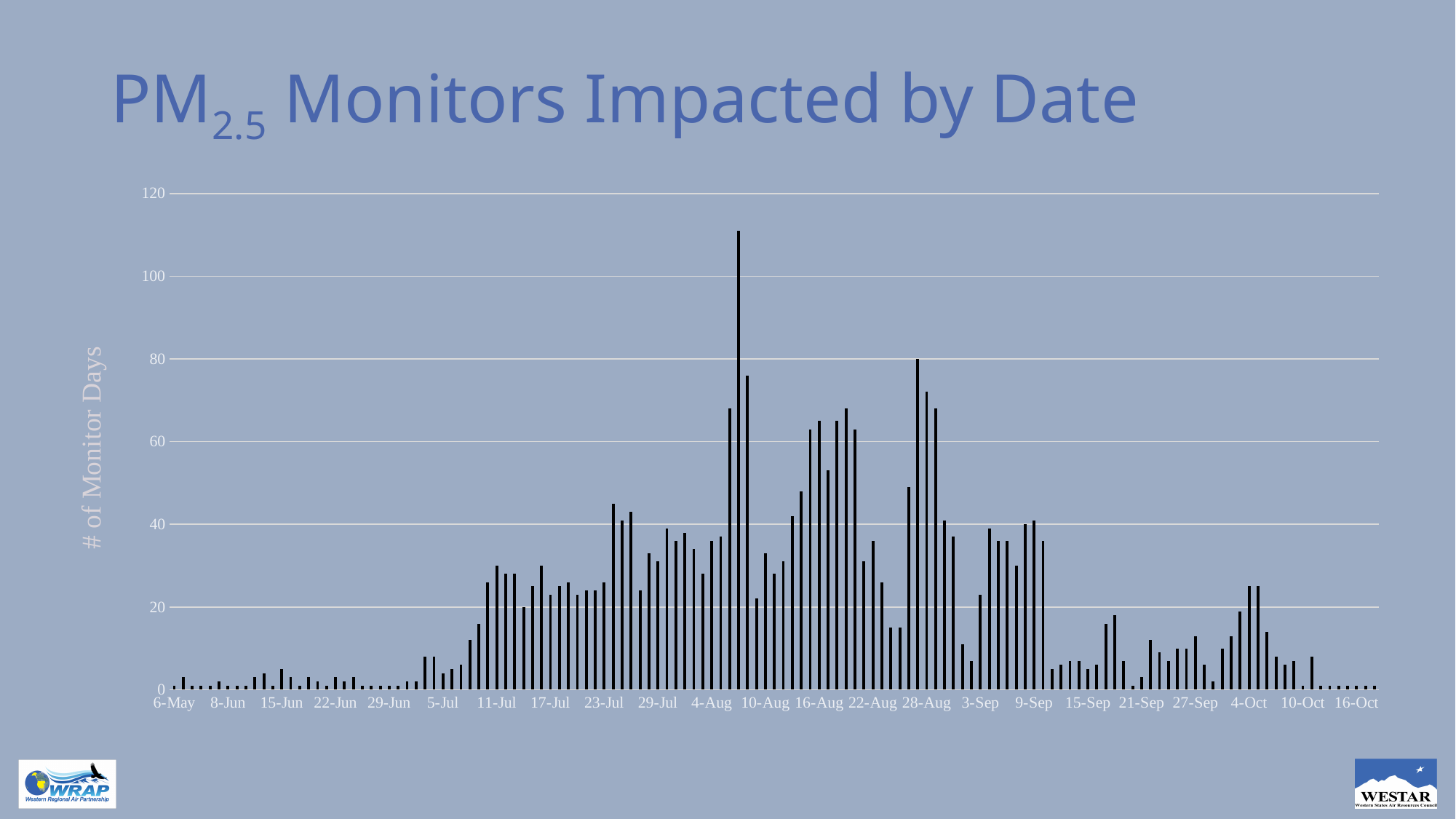
Is the tallest bar on the chart greater or less than 100? greater Is the value for 22-Aug greater or less than 40? less Is the value for 6-May greater or less than 20? less What kind of chart is shown on the slide? bar chart Do the values generally rise or fall along the x axis from 28-Aug to 16-Oct? fall What is the title of the chart on the slide? PM2.5 Monitors Impacted by Date What is the label on the vertical axis of the chart? # of Monitor Days Do the values generally rise or fall along the x axis from 6-May to 4-Aug? rise